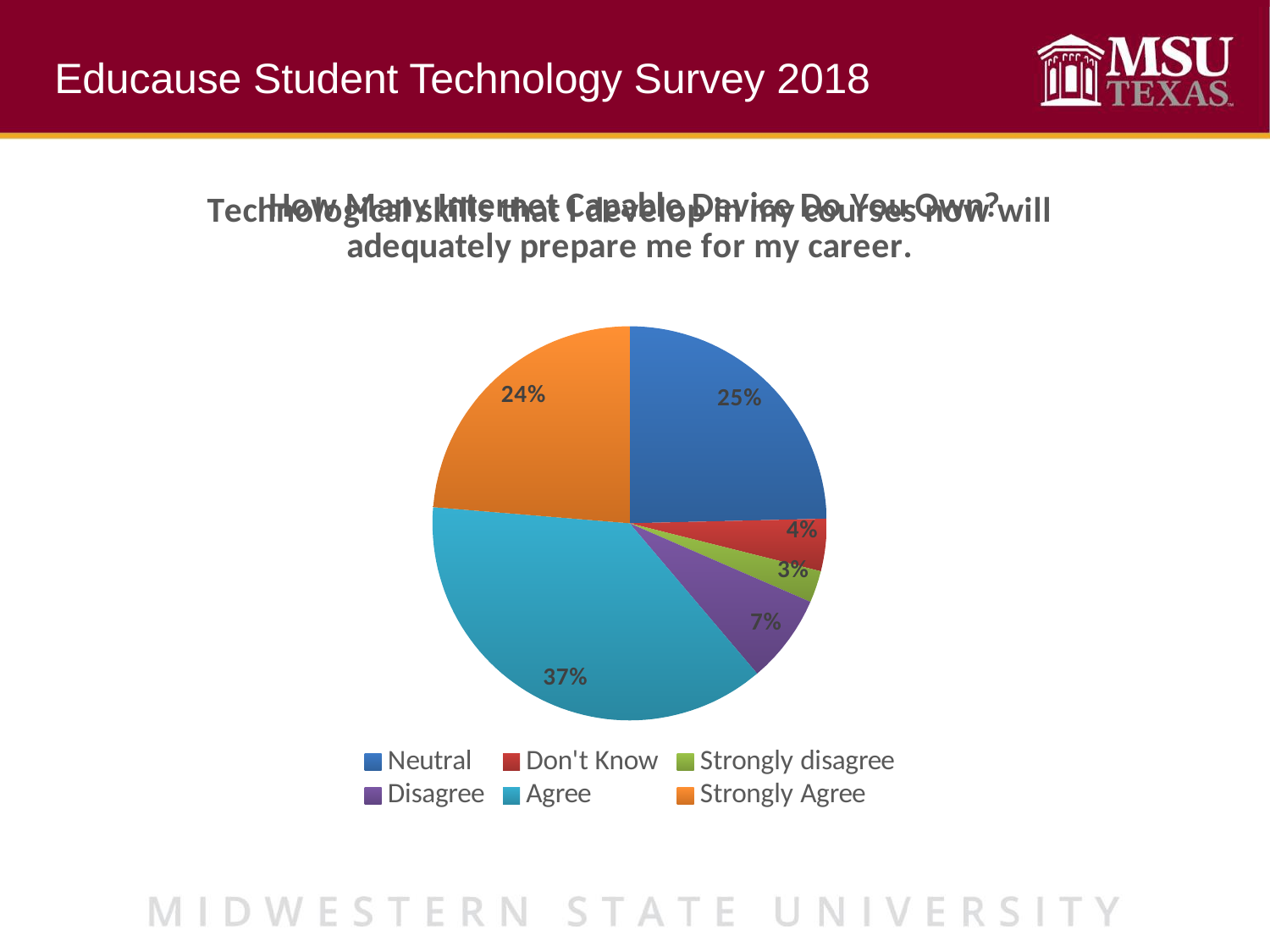
Which slice is larger, Neutral or Strongly Agree? Neutral By how many percentage points does the Agree slice exceed the Neutral slice? 12 Which category has the largest slice of the pie chart? Agree What percentage of the pie chart is labelled Don't Know? 4% What percentage of the pie chart is labelled Disagree? 7% How many categories does the pie chart show? 6 What type of chart is shown on the slide? Pie chart Which category has the smallest slice of the pie chart? Strongly disagree What percentage of the pie chart is labelled Neutral? 25% What colour is the Agree slice in the pie chart? Teal What percentage of the pie chart is labelled Agree? 37% What percentage of the pie chart is labelled Strongly Agree? 24%